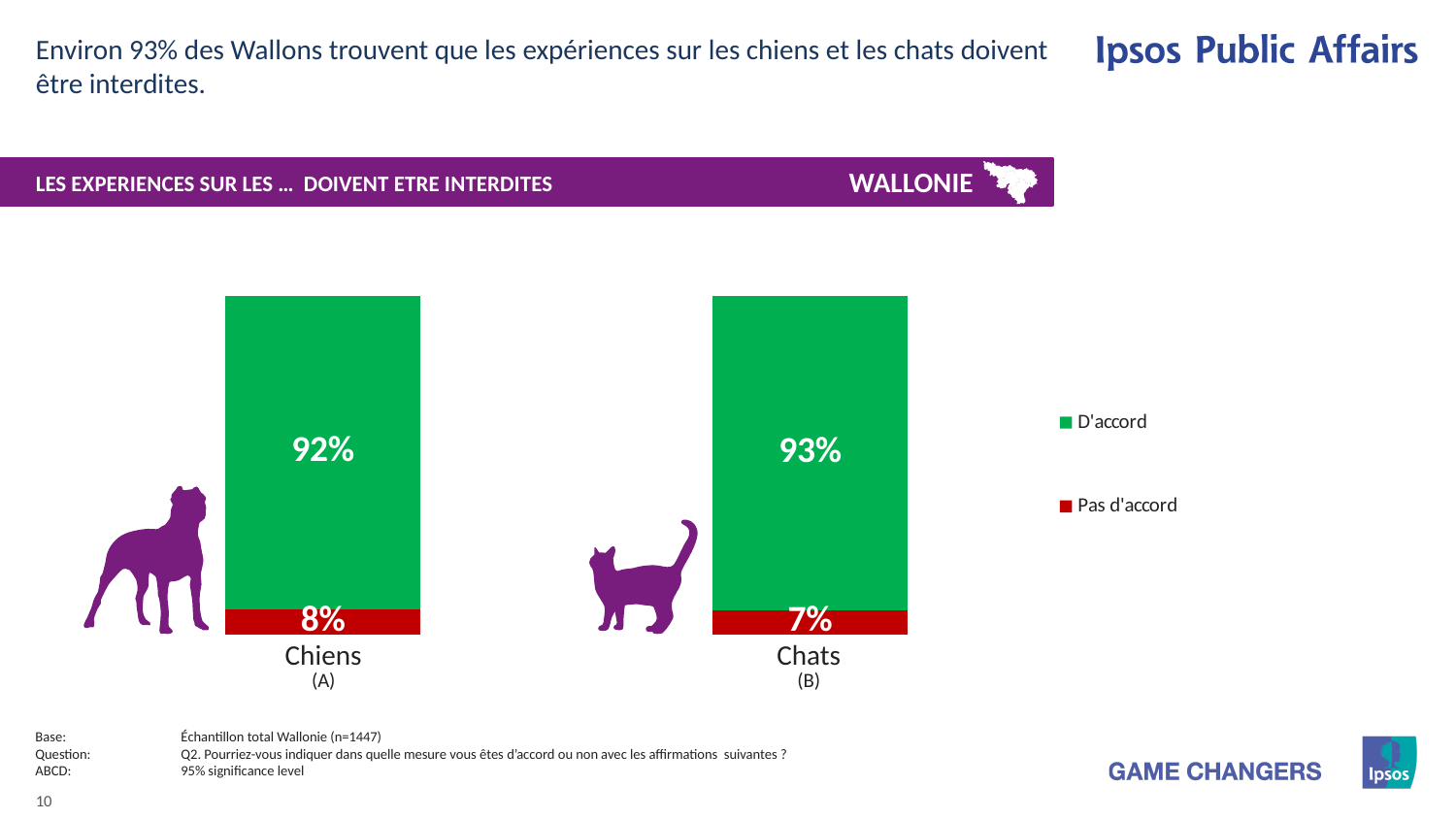
Which category has the higher 'D'accord' share, Chiens or Chats? Chats How many categories are shown on the x axis of the chart? 2 How many series does the legend list? 2 What is the 'Pas d'accord' value for Chats? 7% What kind of chart is shown on the slide? Stacked bar chart What percentage of respondents agree (D'accord) that experiments on dogs (Chiens) should be banned? 92% What is the difference between the 'D'accord' values for Chats and Chiens? 1% What is the total of the stacked bar for Chiens? 100% What is the 'Pas d'accord' value for Chiens? 8% Which category has the lowest 'Pas d'accord' value? Chats What percentage of respondents agree (D'accord) that experiments on cats (Chats) should be banned? 93% Which colour represents 'Pas d'accord' in the chart? Red